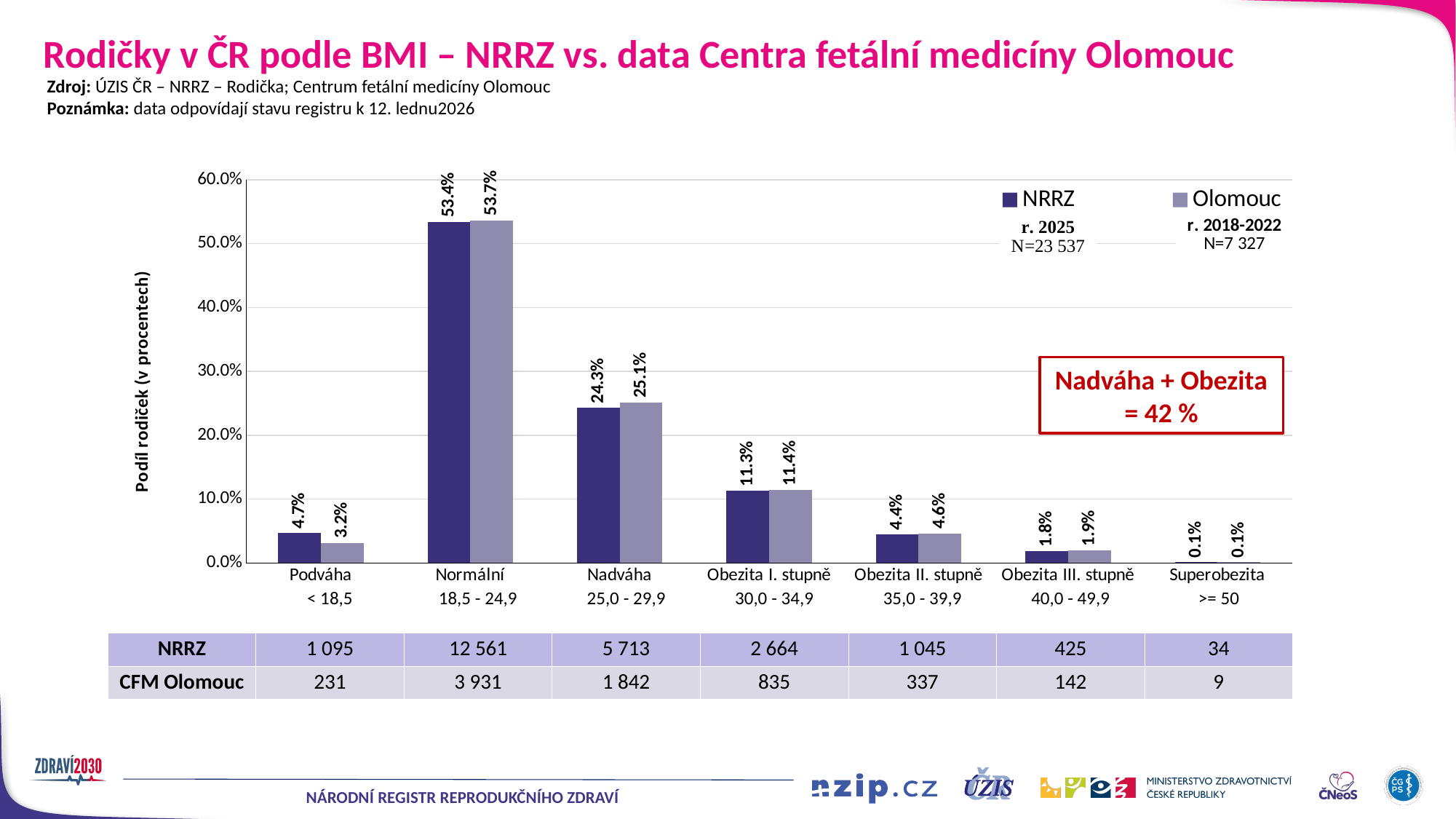
What is the NRRZ value for Podváha? 4.7% What is the Olomouc value for Obezita II. stupně? 4.6% Which is larger for Nadváha, the NRRZ value or the Olomouc value? Olomouc Which category has the highest NRRZ value? Normální How many series does the legend list? 2 What is the label of the y axis? Podíl rodiček (v procentech) What is the Olomouc value for Nadváha? 25.1% How many BMI categories are shown on the x axis? 7 What is the NRRZ value for Normální? 53.4% What kind of chart is shown on the slide? bar chart Which category has the lowest Olomouc value? Superobezita What is the difference between the NRRZ and Olomouc values for Podváha? 1.5%